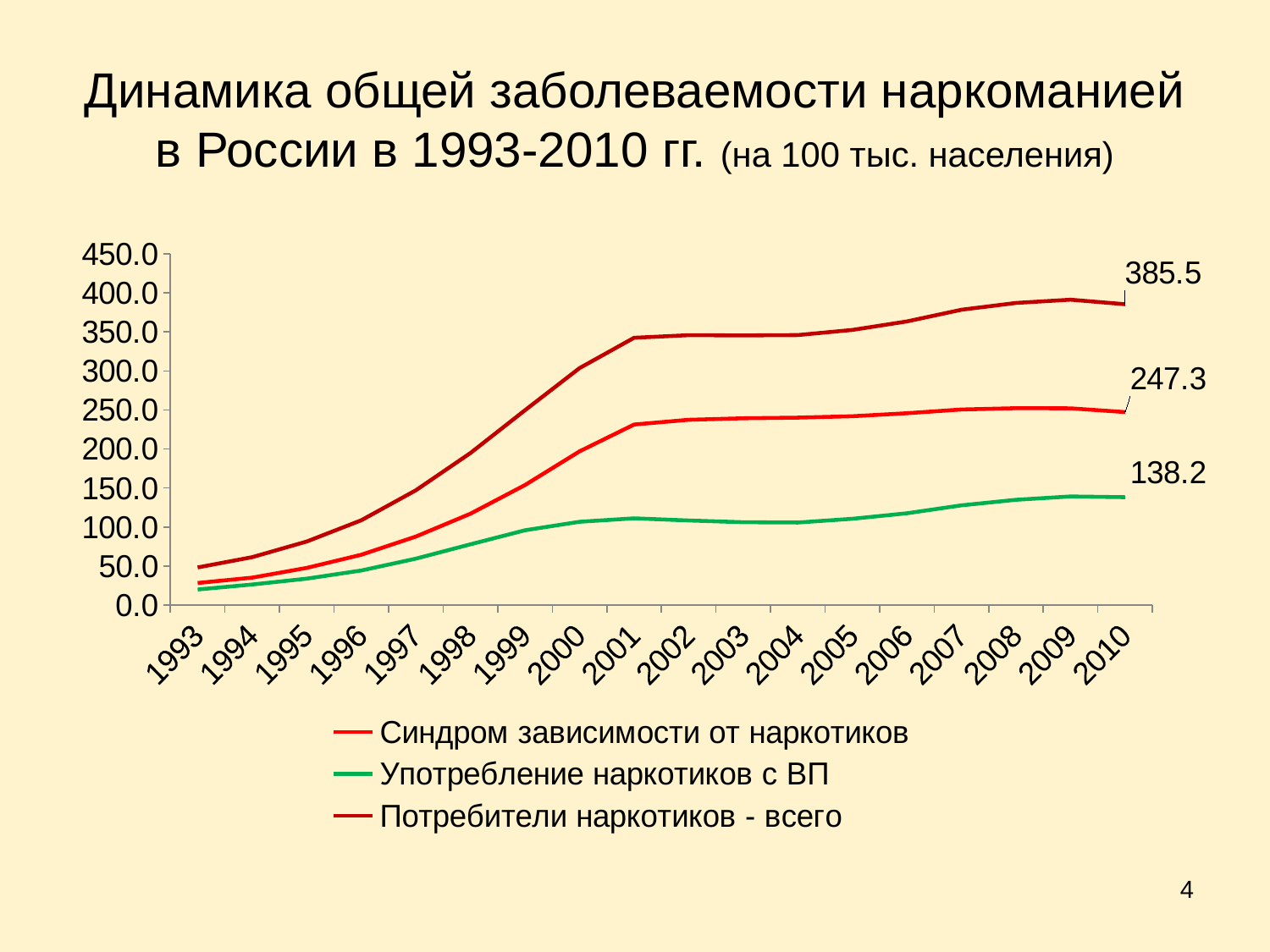
Is the value for "Потребители наркотиков - всего" in 2001 greater or less than 300? greater What is the value for "Употребление наркотиков с ВП" in 2010? 138.2 Which series has the highest value in 2010? Потребители наркотиков - всего Is the value for "Употребление наркотиков с ВП" in 1993 greater or less than 50? less How many series does the legend list? 3 Which series has the lowest value in 2010? Употребление наркотиков с ВП How many years are shown on the x axis? 18 What is the value for "Синдром зависимости от наркотиков" in 2010? 247.3 What is the value for "Потребители наркотиков - всего" in 2010? 385.5 In 2010, what is the difference between "Синдром зависимости от наркотиков" and "Употребление наркотиков с ВП"? 109.1 What kind of chart is shown on the slide? line chart In 2010, what is the difference between "Потребители наркотиков - всего" and "Синдром зависимости от наркотиков"? 138.2